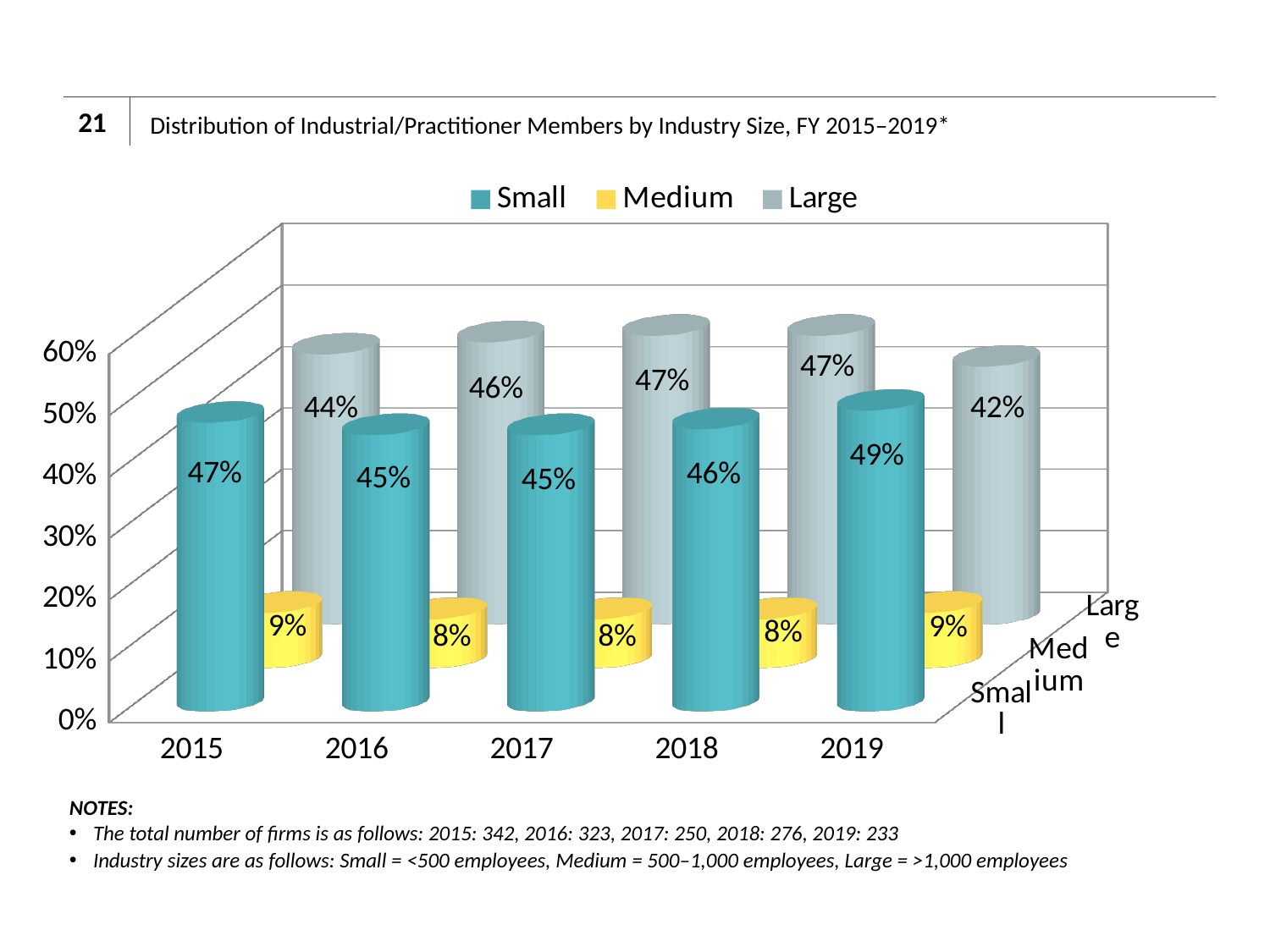
What is the value for Large in 2015? 44% How many series does the legend list? 3 Which is larger in 2017, Small or Large? Large Is the value for Medium in 2015 greater or less than 20%? less What is the difference between the Small and Large values in 2019? 7% What kind of chart is shown on the slide? bar chart In which year is the Large series lowest? 2019 In which year is the Small series highest? 2019 What is the value for Medium in 2017? 8% What is the title of the chart? Distribution of Industrial/Practitioner Members by Industry Size, FY 2015–2019* How many years are shown on the x axis? 5 What is the value for Small in 2019? 49%